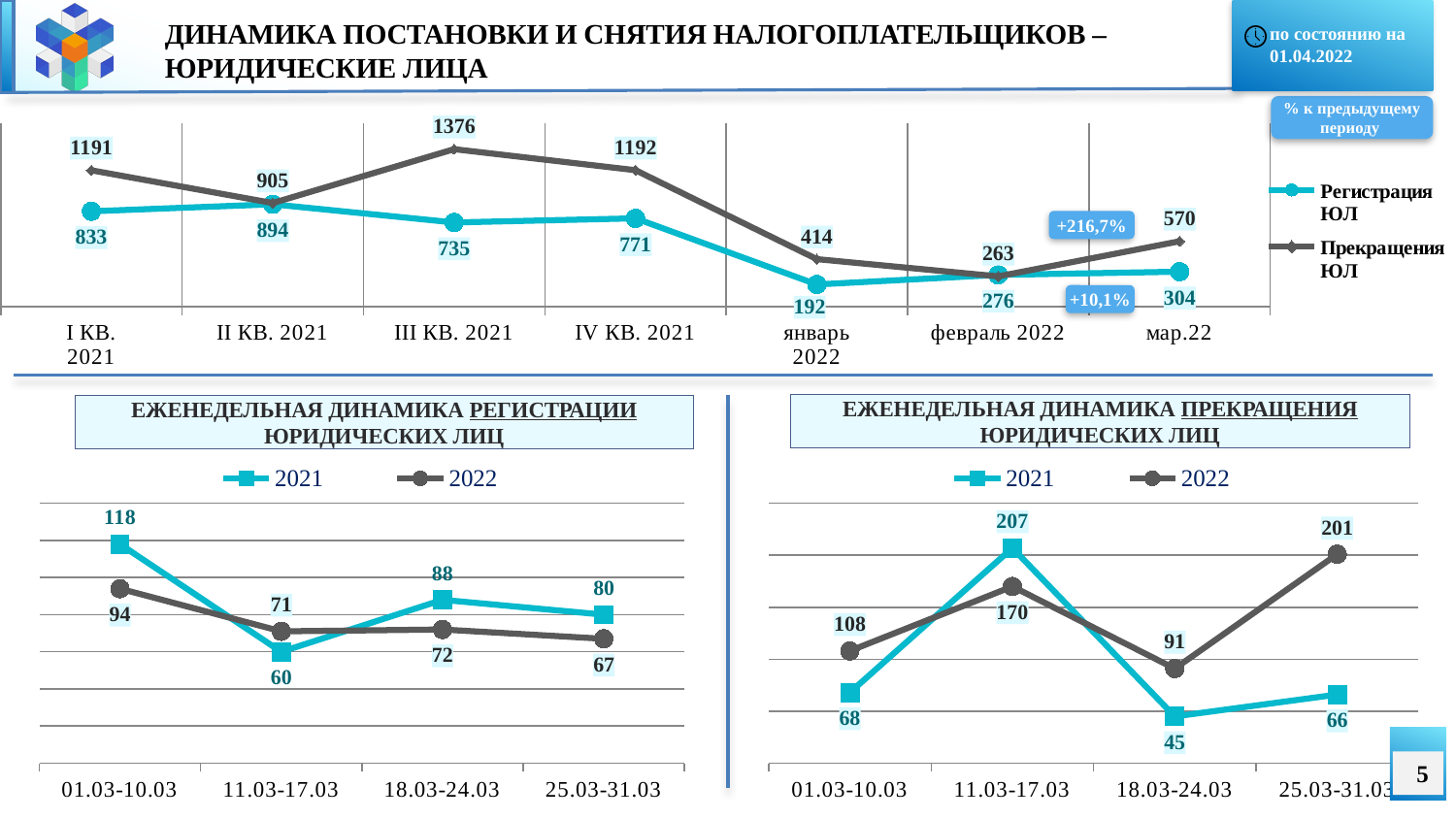
In the bottom-right chart (ЕЖЕНЕДЕЛЬНАЯ ДИНАМИКА ПРЕКРАЩЕНИЯ ЮРИДИЧЕСКИХ ЛИЦ), which week has the highest 2022 value? 25.03-31.03 In the top chart, which period has the lowest value for Регистрация ЮЛ? январь 2022 In the top chart, what is the value of Прекращения ЮЛ for III КВ. 2021? 1376 What type of chart is the bottom-left chart (ЕЖЕНЕДЕЛЬНАЯ ДИНАМИКА РЕГИСТРАЦИИ ЮРИДИЧЕСКИХ ЛИЦ)? line chart In the bottom-left chart (ЕЖЕНЕДЕЛЬНАЯ ДИНАМИКА РЕГИСТРАЦИИ ЮРИДИЧЕСКИХ ЛИЦ), which is larger for 11.03-17.03: 2021 or 2022? 2022 In the bottom-left chart (ЕЖЕНЕДЕЛЬНАЯ ДИНАМИКА РЕГИСТРАЦИИ ЮРИДИЧЕСКИХ ЛИЦ), what is the 2021 value for 01.03-10.03? 118 In the top chart, what is the difference between Прекращения ЮЛ and Регистрация ЮЛ for I КВ. 2021? 358 In the bottom-right chart (ЕЖЕНЕДЕЛЬНАЯ ДИНАМИКА ПРЕКРАЩЕНИЯ ЮРИДИЧЕСКИХ ЛИЦ), what is the difference between the 2021 and 2022 values for 18.03-24.03? 46 In the top chart, how many periods are shown on the x axis? 7 In the top chart, which period has the highest value for Прекращения ЮЛ? III КВ. 2021 In the top chart, what is the value of Регистрация ЮЛ for январь 2022? 192 In the top chart, how many series does the legend list? 2